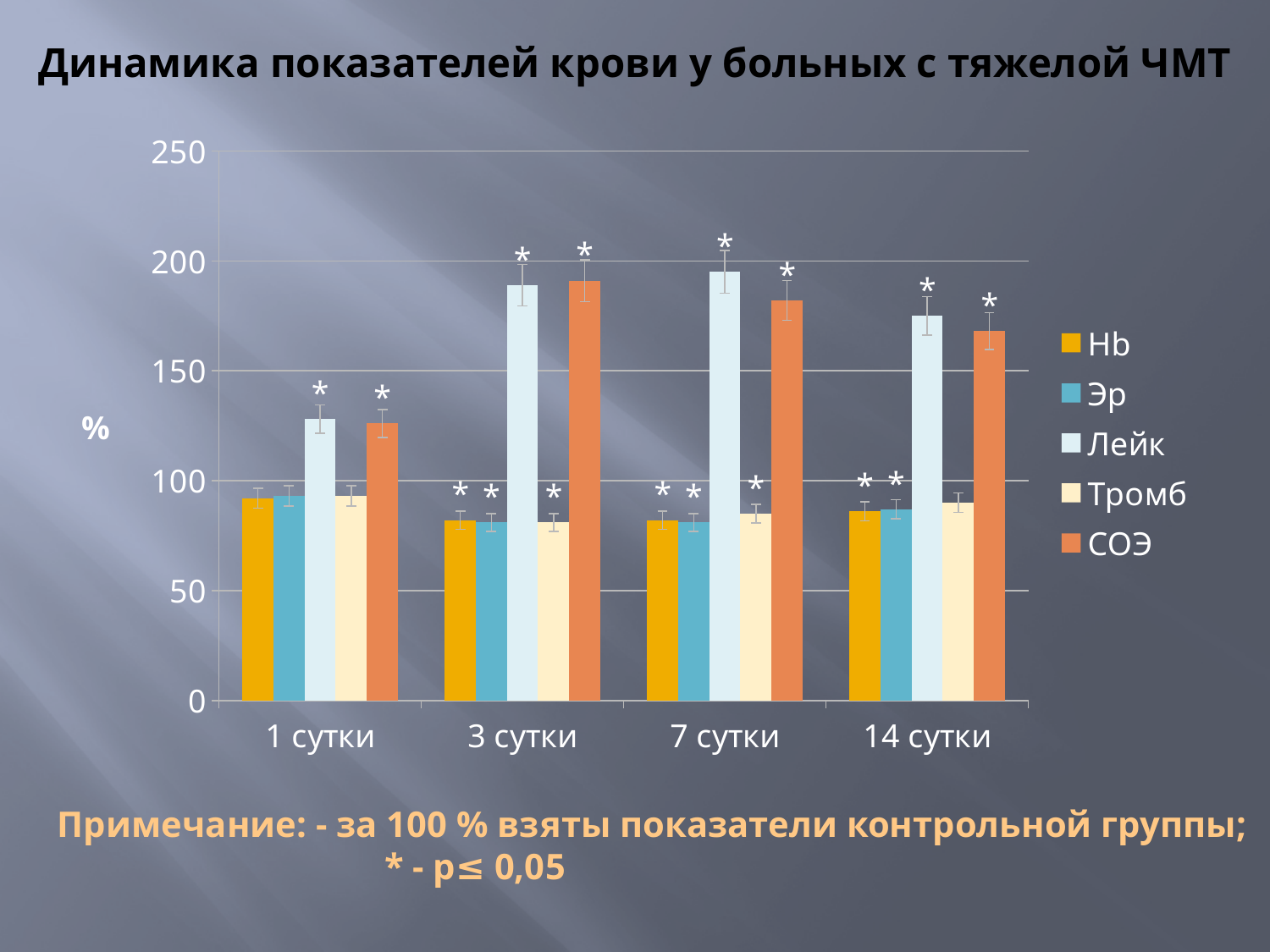
Is the value for Лейк at 3 сутки greater or less than 150? greater At which time point is the value for СОЭ lowest? 1 сутки How many time-point categories are shown on the x axis? 4 Does the value for СОЭ rise or fall from 3 сутки to 14 сутки? fall Which is larger: Лейк at 7 сутки or Лейк at 1 сутки? Лейк at 7 сутки Is the value for СОЭ at 1 сутки greater or less than 100? greater What kind of chart is shown on the slide? bar chart How many series does the legend list? 5 Is the value for Тромб at 14 сутки greater or less than 100? less Which series has the highest value at 7 сутки? Лейк What is the label on the y axis? %